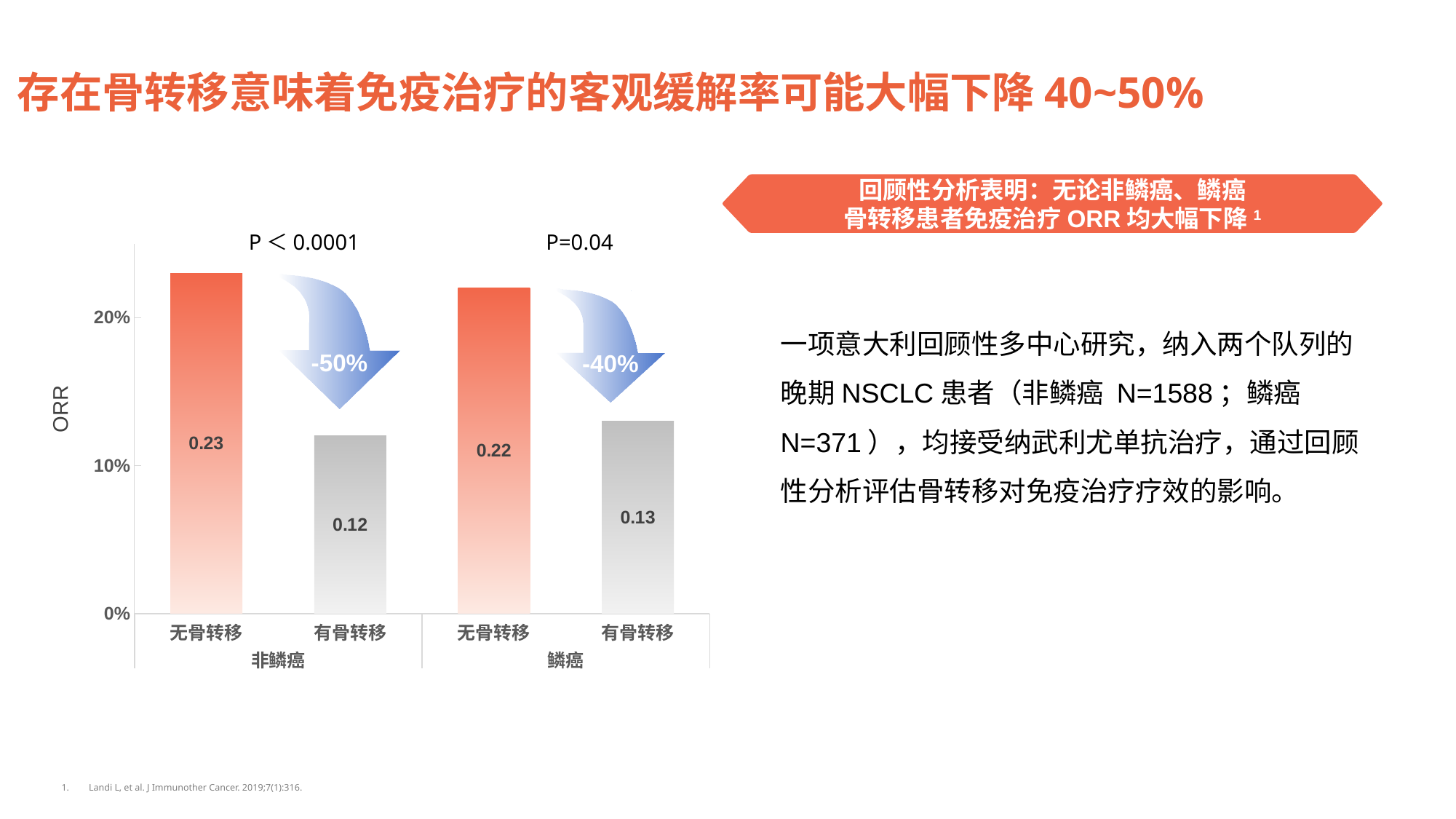
How many bars are plotted in the chart? 4 Which bar has the highest ORR value? 无骨转移 (非鳞癌) What is the ORR value for 有骨转移 in the 鳞癌 group? 0.13 What is the ORR value for 无骨转移 in the 鳞癌 group? 0.22 What kind of chart is shown on the slide? Bar chart What is the difference in ORR between 无骨转移 and 有骨转移 in the 鳞癌 group? 0.09 What is the difference in ORR between 无骨转移 and 有骨转移 in the 非鳞癌 group? 0.11 What is the ORR value for 无骨转移 in the 非鳞癌 group? 0.23 What is the ORR value for 有骨转移 in the 非鳞癌 group? 0.12 Which bar has the lowest ORR value? 有骨转移 (非鳞癌) What percentage decrease is shown by the arrow for the 鳞癌 group? -40% Which is larger, the ORR for 无骨转移 in 非鳞癌 or the ORR for 无骨转移 in 鳞癌? 无骨转移 in 非鳞癌